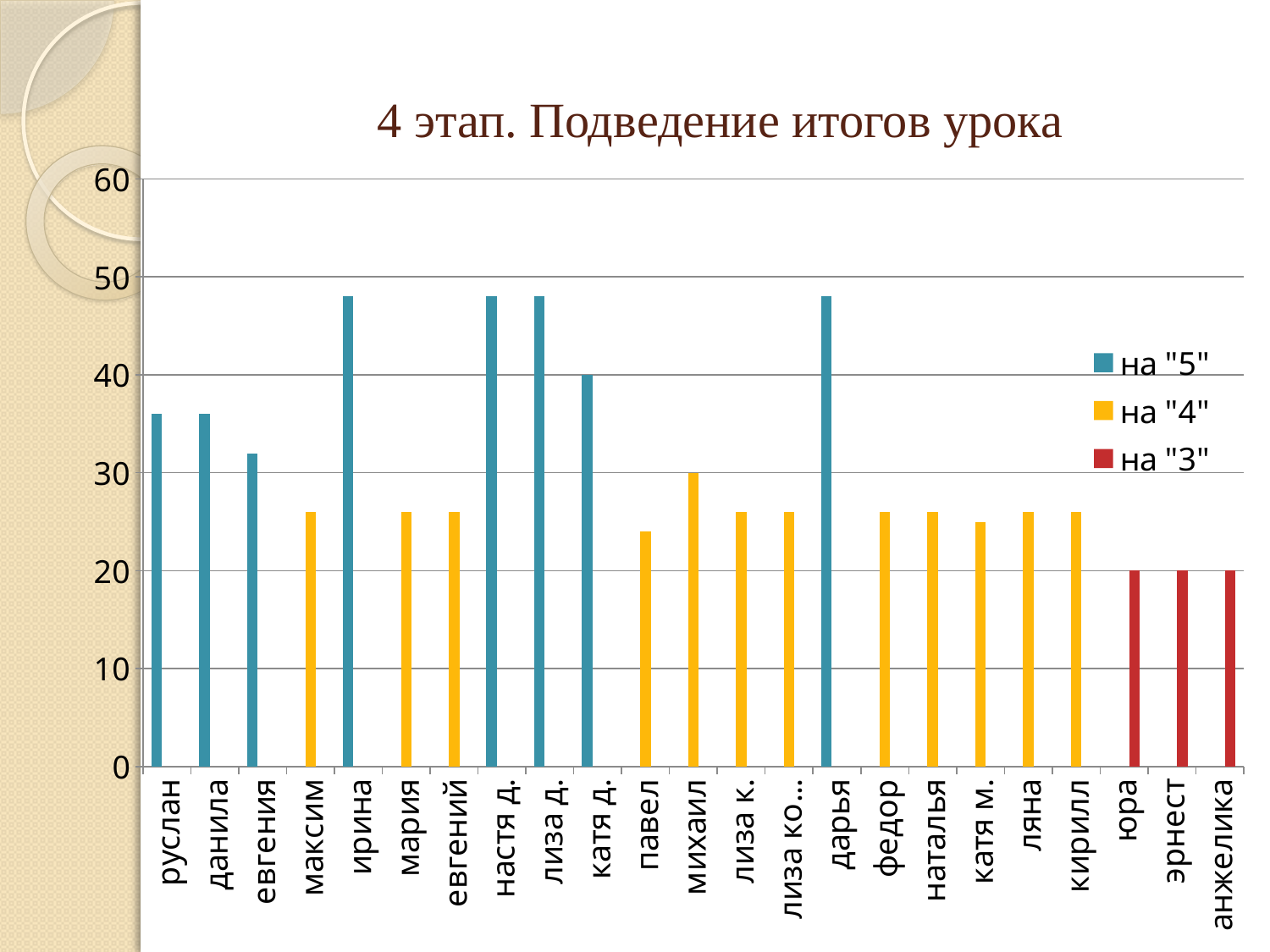
What is the value for михаил? 30 Is the value for ирина greater or less than 40? greater Which is larger, the value for михаил or the value for павел? михаил What kind of chart is shown on the slide? bar chart Is the value for павел greater or less than 30? less How many series does the legend list? 3 Which is larger, the value for ирина or the value for руслан? ирина Is the value for руслан greater or less than 30? greater What is the value for юра? 20 What is the value for катя д.? 40 How many students (categories) are shown on the x axis? 23 Which series is shown in red in the legend? на "3"